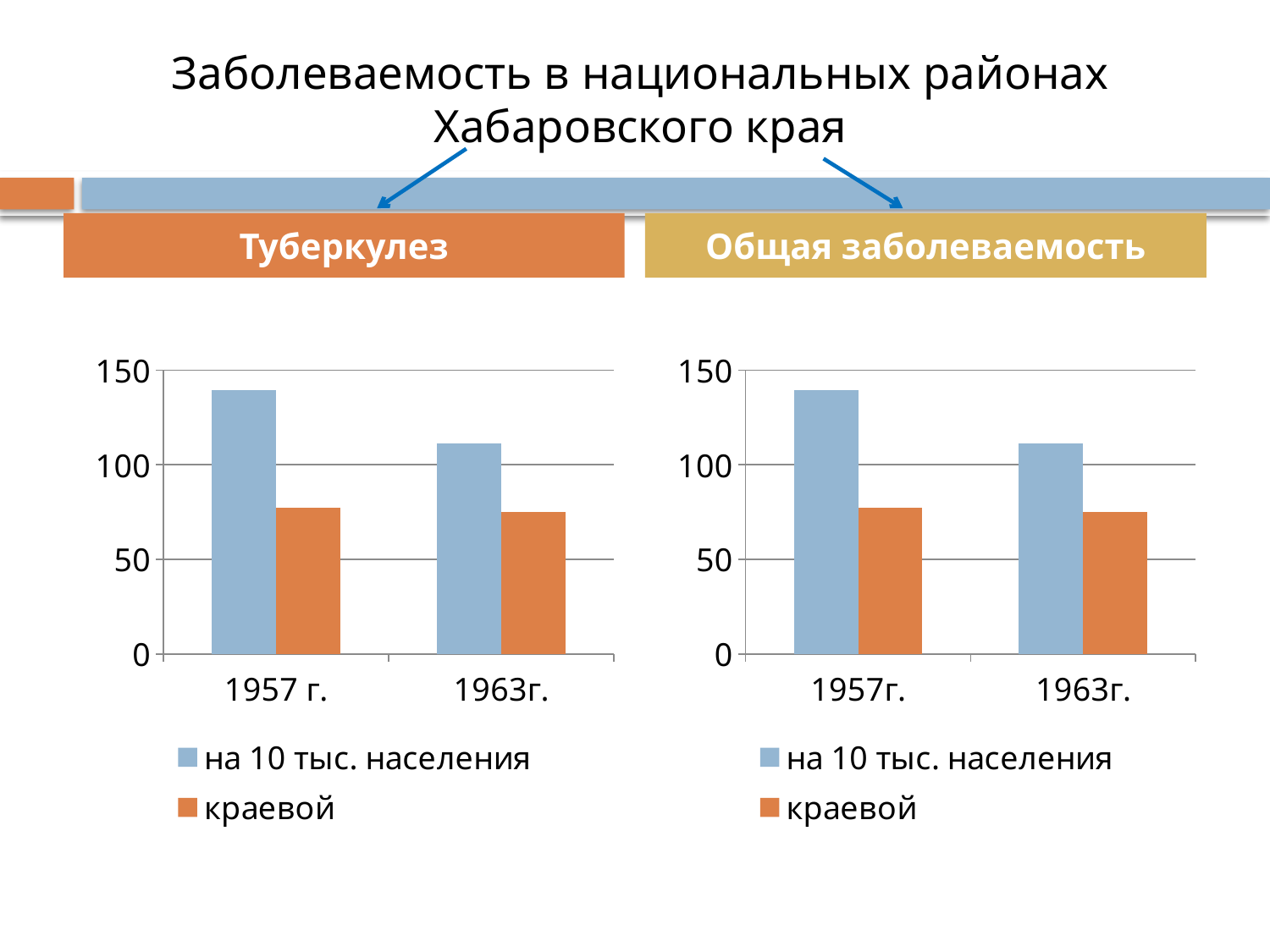
What are the two legend entries of the left chart under "Туберкулез"? на 10 тыс. населения; краевой How many categories are shown on the x axis of the left chart under "Туберкулез"? 2 In the left chart under "Туберкулез", which is larger in 1957 г.: "на 10 тыс. населения" or "краевой"? на 10 тыс. населения In the left chart under "Туберкулез", is the value for "краевой" in 1963г. greater or less than 100? less What kind of chart is the left chart under "Туберкулез"? bar chart In the left chart under "Туберкулез", does the value for "на 10 тыс. населения" rise or fall from 1957 г. to 1963г.? fall In the right chart under "Общая заболеваемость", is the value for "на 10 тыс. населения" in 1963г. greater or less than 100? greater In the left chart under "Туберкулез", is the value for "на 10 тыс. населения" in 1957 г. greater or less than 100? greater How many series does the legend of the right chart under "Общая заболеваемость" list? 2 What colour are the "краевой" bars in the right chart under "Общая заболеваемость"? orange In the right chart under "Общая заболеваемость", which year has the higher value for "на 10 тыс. населения"? 1957г.